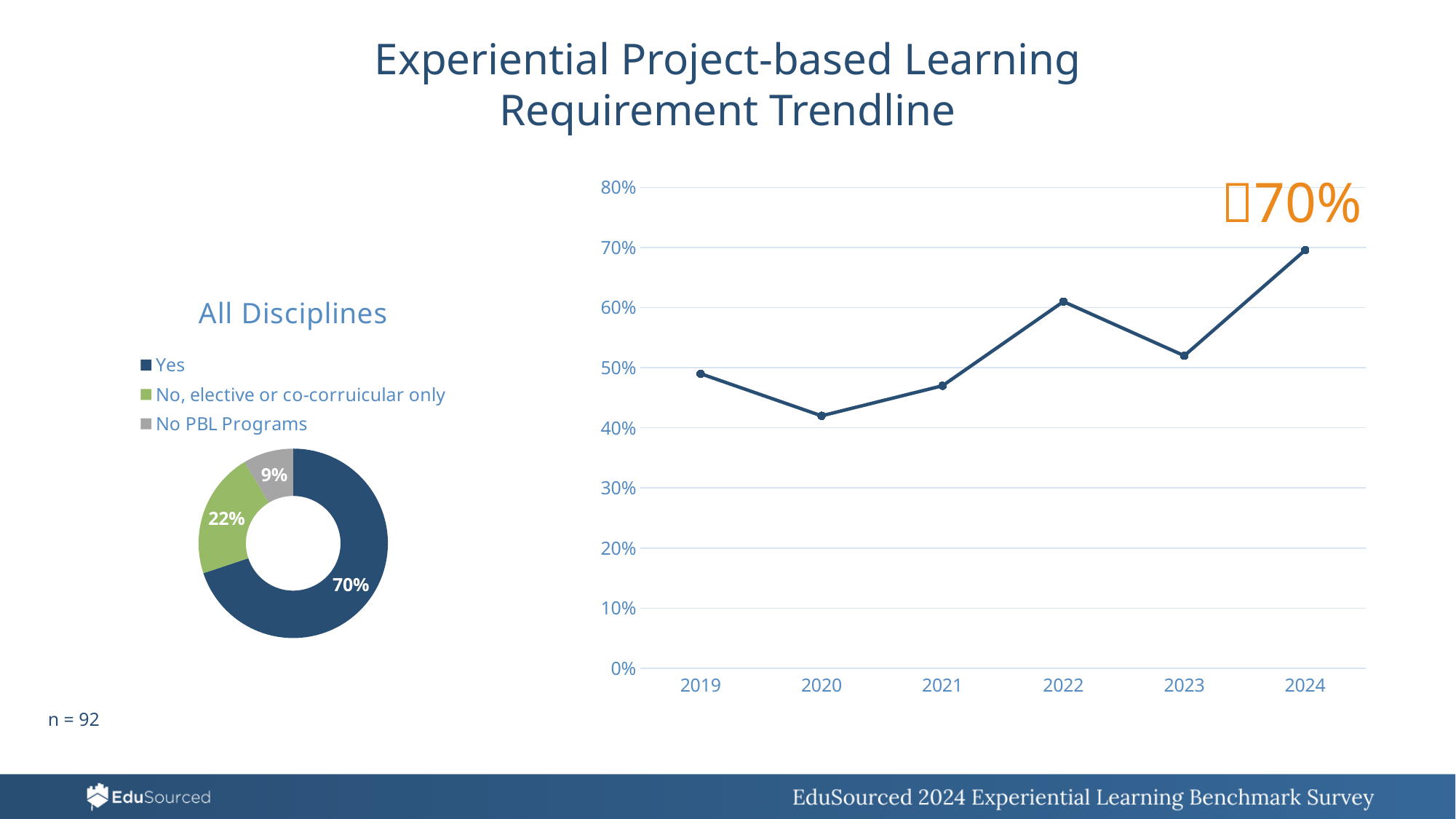
In the line chart on the right, which year has the lowest value? 2020 In the All Disciplines donut chart, what percentage is shown for 'No, elective or co-corruicular only'? 22% In the All Disciplines donut chart, what percentage is shown for No PBL Programs? 9% How many categories does the All Disciplines donut chart legend list? 3 In the line chart on the right, is the value for 2020 greater or less than 50%? less In the All Disciplines donut chart, what is the difference in percentage points between Yes and 'No, elective or co-corruicular only'? 48 In the line chart on the right, is the value for 2024 greater or less than 60%? greater What kind of chart is the All Disciplines chart on the left? Donut (pie) chart In the line chart on the right, which year has the larger value, 2022 or 2023? 2022 In the line chart on the right, which year has the highest value? 2024 In the All Disciplines donut chart, which category has the smallest share? No PBL Programs In the All Disciplines donut chart, what percentage is shown for Yes? 70%